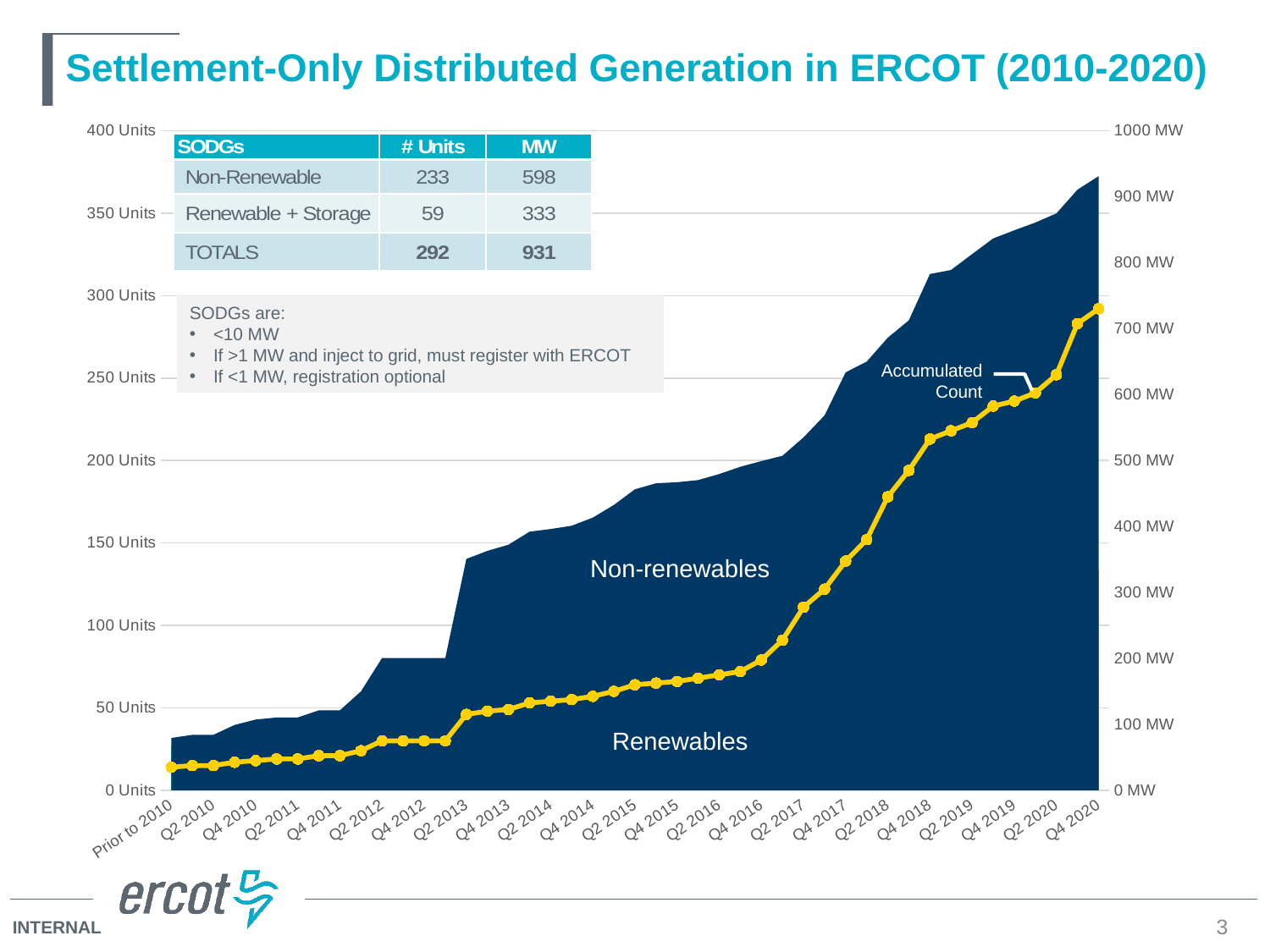
What kind of chart is shown on the slide? Area chart with a line overlay What colour is the Accumulated Count line? Yellow According to the table on the slide, how many MW do Non-Renewable SODGs total? 598 Is the Accumulated Count at Q4 2020 greater or less than 250 Units? greater How many series are plotted on the chart? 3 What is the maximum value shown on the right-hand MW axis? 1000 MW What is the title of the slide's chart? Settlement-Only Distributed Generation in ERCOT (2010-2020) Does the Accumulated Count rise or fall from Prior to 2010 to Q4 2020? Rises Is the total MW (top of the stacked area) at Q4 2020 greater or less than 800 MW? greater Is the Accumulated Count at Q4 2016 greater or less than 100 Units? less At Q4 2020, which area is larger in MW: Non-renewables or Renewables? Non-renewables